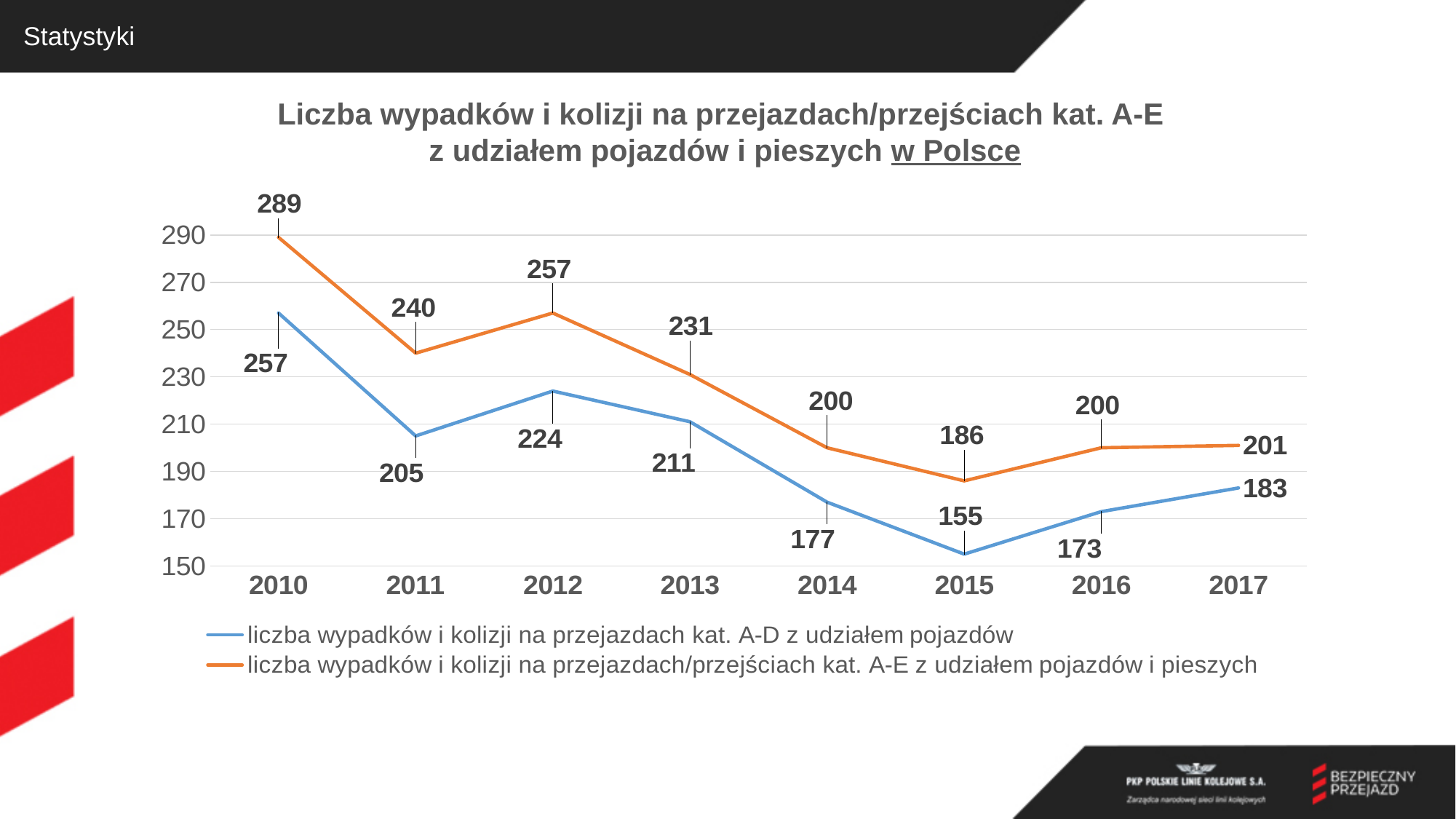
Which is larger: the value for 2011 or the value for 2013 in the series 'liczba wypadków i kolizji na przejazdach kat. A-D z udziałem pojazdów'? 2013 How many years are plotted along the x axis? 8 In which year is the series 'liczba wypadków i kolizji na przejazdach/przejściach kat. A-E z udziałem pojazdów i pieszych' at its highest? 2010 What is the difference between the two series' values in 2012? 33 What type of chart is shown on the slide? line chart What colour is the line for the series 'liczba wypadków i kolizji na przejazdach kat. A-D z udziałem pojazdów'? blue What is the value for 2017 in the series 'liczba wypadków i kolizji na przejazdach/przejściach kat. A-E z udziałem pojazdów i pieszych'? 201 What is the value for 2010 in the series 'liczba wypadków i kolizji na przejazdach/przejściach kat. A-E z udziałem pojazdów i pieszych'? 289 Does the series 'liczba wypadków i kolizji na przejazdach/przejściach kat. A-E z udziałem pojazdów i pieszych' generally rise or fall from 2010 to 2015? fall How many series does the legend list? 2 What is the value for 2015 in the series 'liczba wypadków i kolizji na przejazdach kat. A-D z udziałem pojazdów'? 155 In which year is the series 'liczba wypadków i kolizji na przejazdach kat. A-D z udziałem pojazdów' at its lowest? 2015